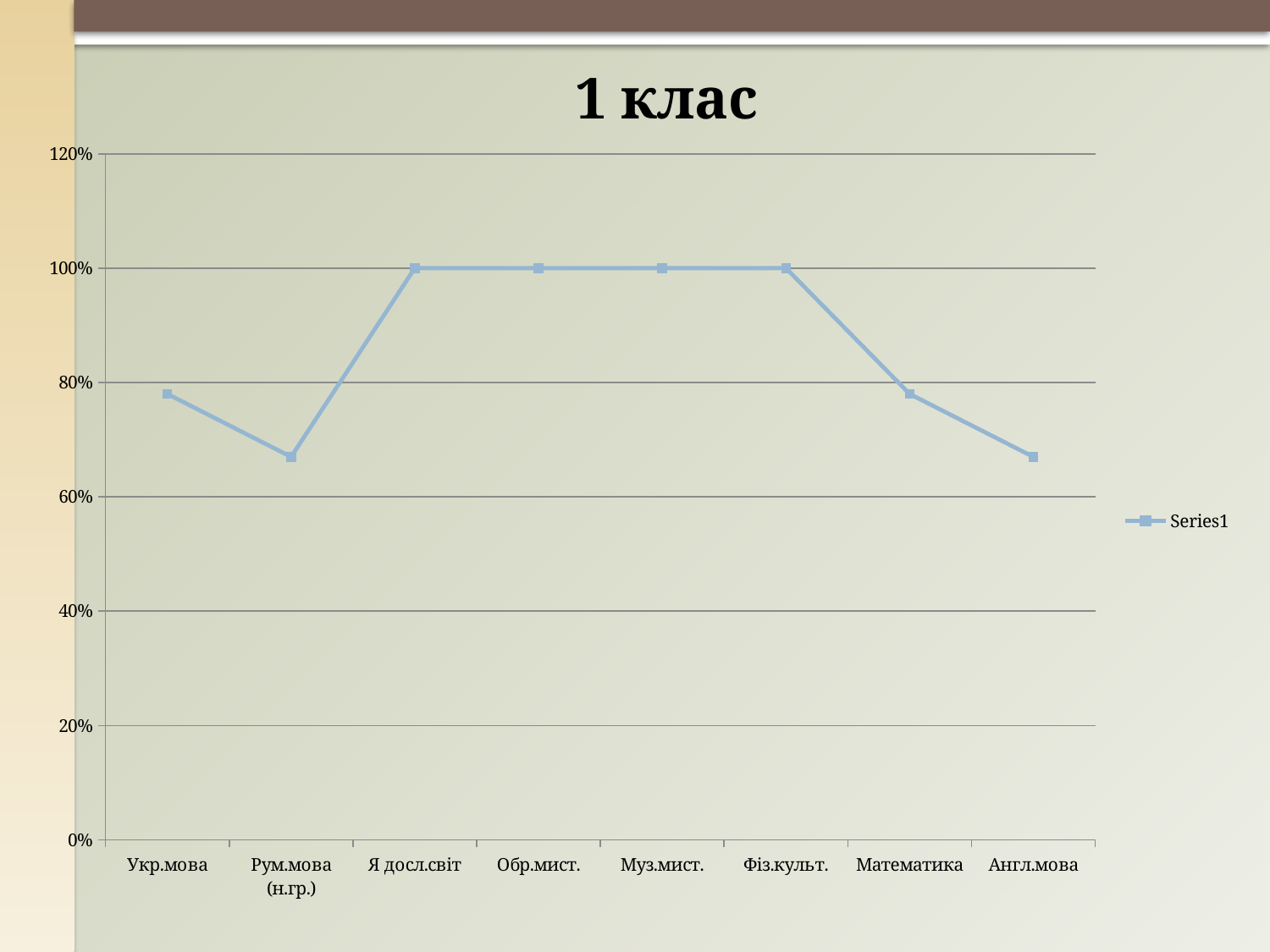
What is the title of the chart? 1 клас Which is larger, the value for Укр.мова or the value for Рум.мова (н.гр.)? Укр.мова What type of chart is shown on the slide? line chart What is the value for Фіз.культ.? 100% Is the value for Англ.мова greater or less than 80%? less Which is larger, the value for Обр.мист. or the value for Математика? Обр.мист. Is the value for Рум.мова (н.гр.) greater or less than 60%? greater What is the value for Я досл.світ? 100% Is the value for Укр.мова greater or less than 80%? less How many series does the legend list? 1 How many categories are shown on the x axis? 8 Do the values rise or fall from Фіз.культ. to Англ.мова? fall